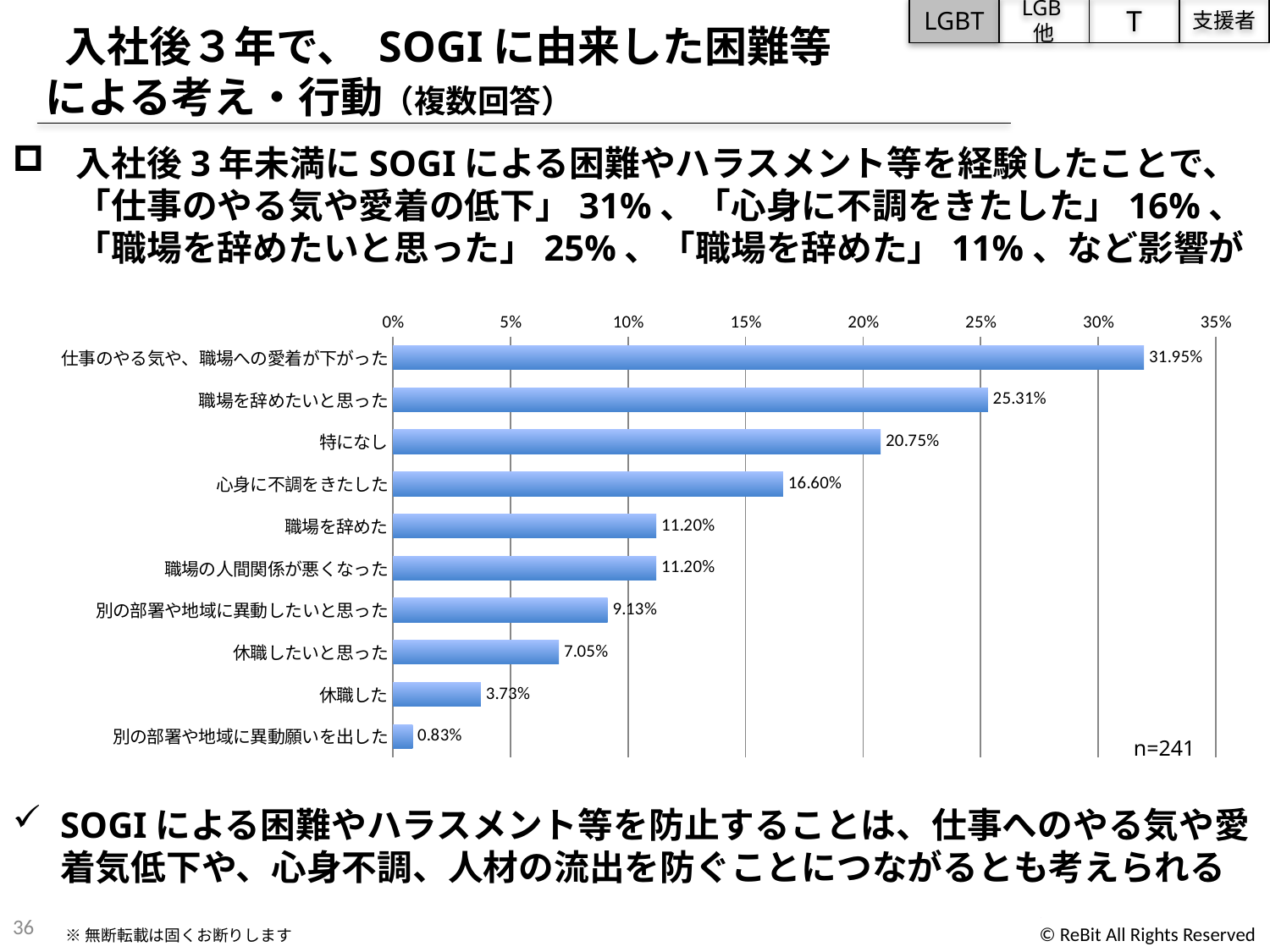
Is the value for 別の部署や地域に異動したいと思った greater or less than 10%? less What is the value for 仕事のやる気や、職場への愛着が下がった? 31.95% What is the difference between 職場を辞めたいと思った and 職場を辞めた? 14.11% What kind of chart is shown on the slide? bar chart Which category has the highest value? 仕事のやる気や、職場への愛着が下がった What is the maximum value shown on the x axis? 35% What is the value for 休職した? 3.73% What is the value for 心身に不調をきたした? 16.60% Which is larger, 特になし or 心身に不調をきたした? 特になし What is the sample size (n) shown on the chart? n=241 How many categories are shown in the chart? 10 Which category has the lowest value? 別の部署や地域に異動願いを出した